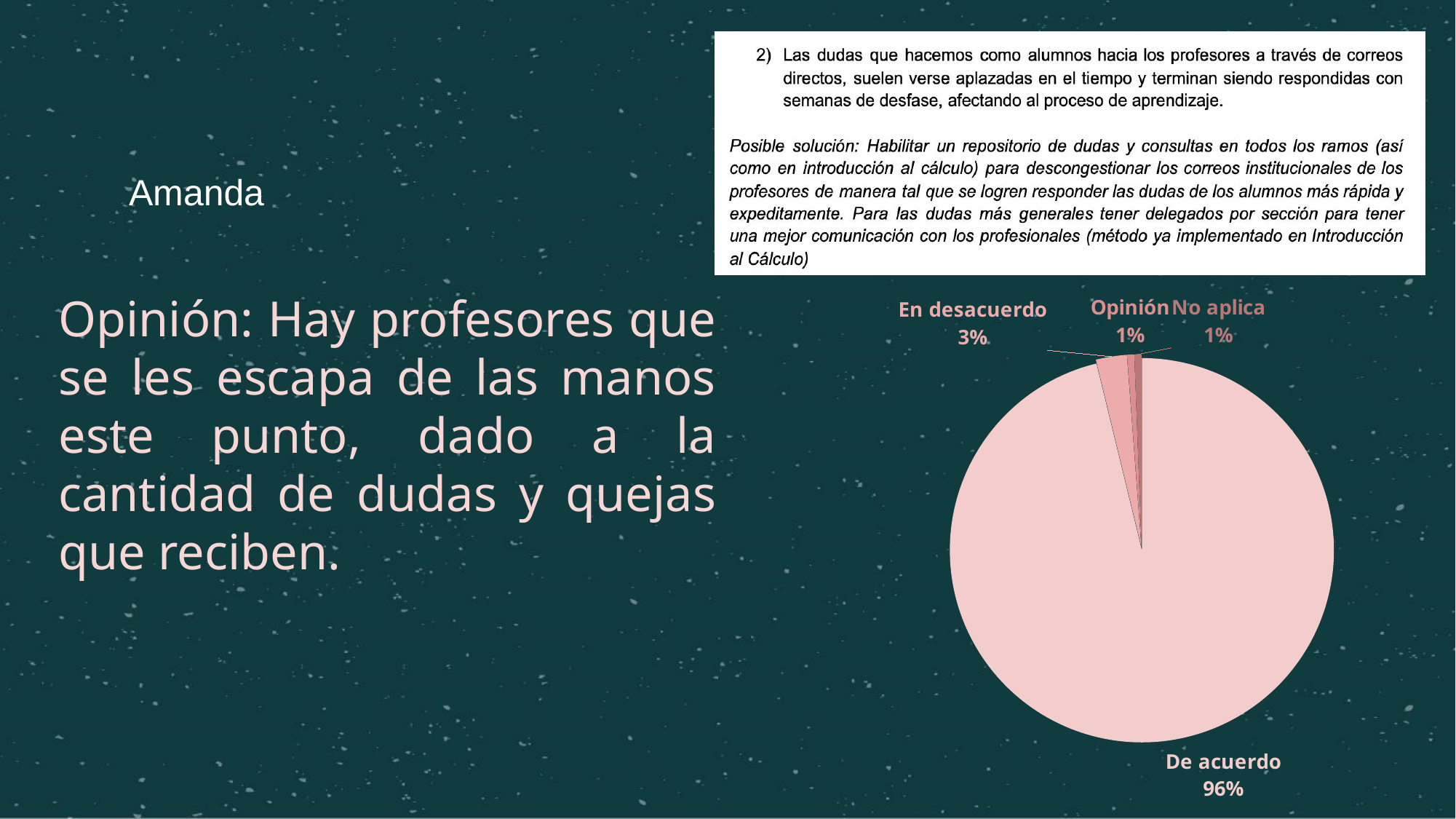
Which slice is larger, "En desacuerdo" or "No aplica"? En desacuerdo How many slices does the pie chart have? 4 What share of the pie does the "De acuerdo" slice represent? 96% Which slice label appears at the bottom right of the pie chart? De acuerdo What percentage of the pie chart is labelled "En desacuerdo"? 3% What is the combined share of the "Opinión" and "No aplica" slices? 2% Which slice of the pie chart is the largest? De acuerdo What kind of chart is shown on the slide? pie chart What percentage of the pie chart is labelled "De acuerdo"? 96% What percentage of the pie chart is labelled "Opinión"? 1% What percentage of the pie chart is labelled "No aplica"? 1% What is the difference in percentage points between the "De acuerdo" and "En desacuerdo" slices? 93